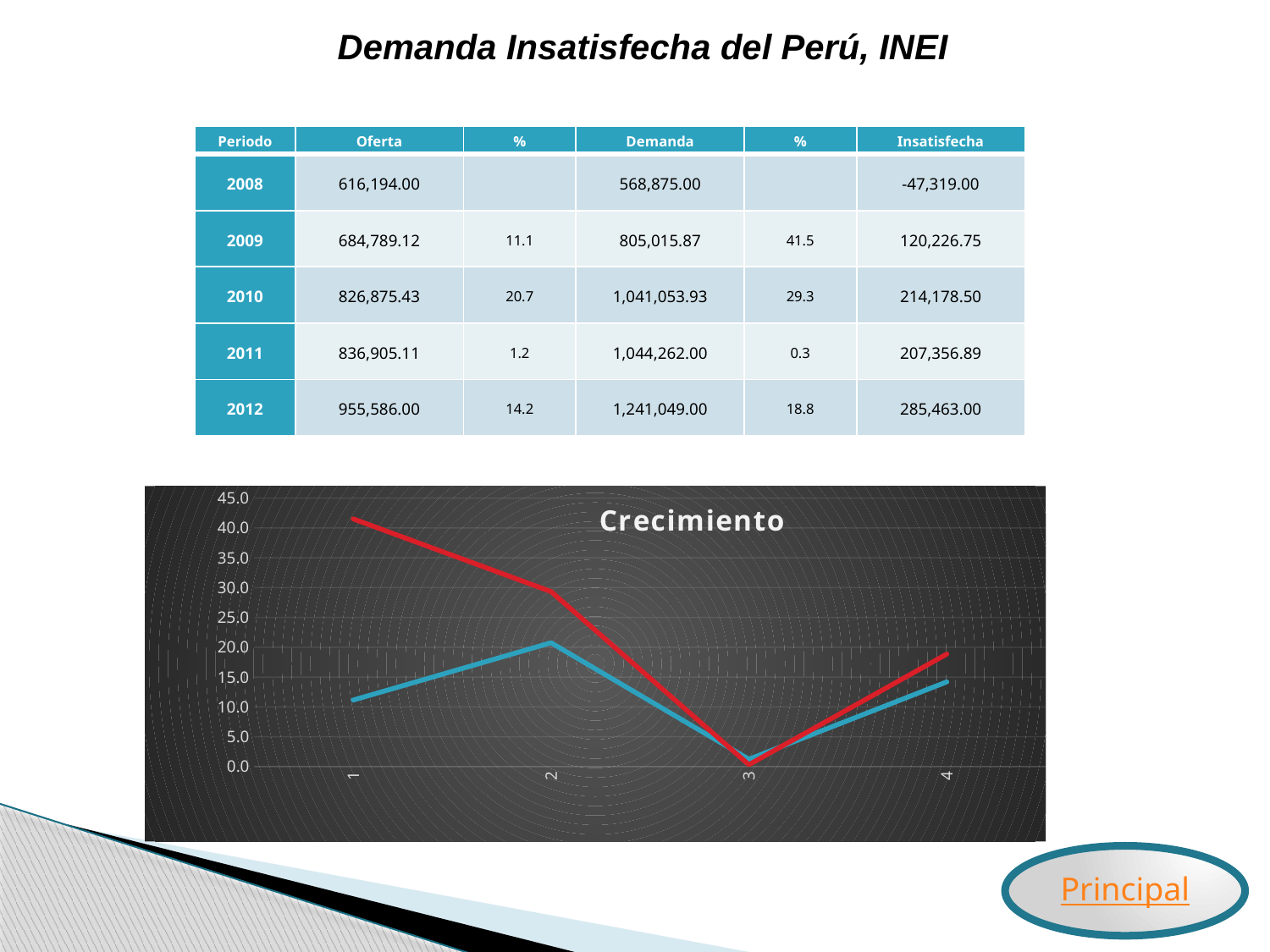
In the "Crecimiento" chart, is the value of the red line at point 3 greater or less than 5.0? less What is the title of the chart on the slide? Crecimiento What kind of chart is the "Crecimiento" chart? line chart In the "Crecimiento" chart, is the value of the red line at point 4 greater or less than 15.0? greater In the "Crecimiento" chart, at which x-axis point does the red line reach its highest value? 1 How many points are plotted along the x axis of the "Crecimiento" chart? 4 In the "Crecimiento" chart, at which x-axis point does the blue line reach its lowest value? 3 In the "Crecimiento" chart, which line is higher at point 1, the red line or the blue line? red line In the "Crecimiento" chart, is the value of the red line at point 2 greater or less than 25.0? greater What is the highest tick value shown on the y axis of the "Crecimiento" chart? 45.0